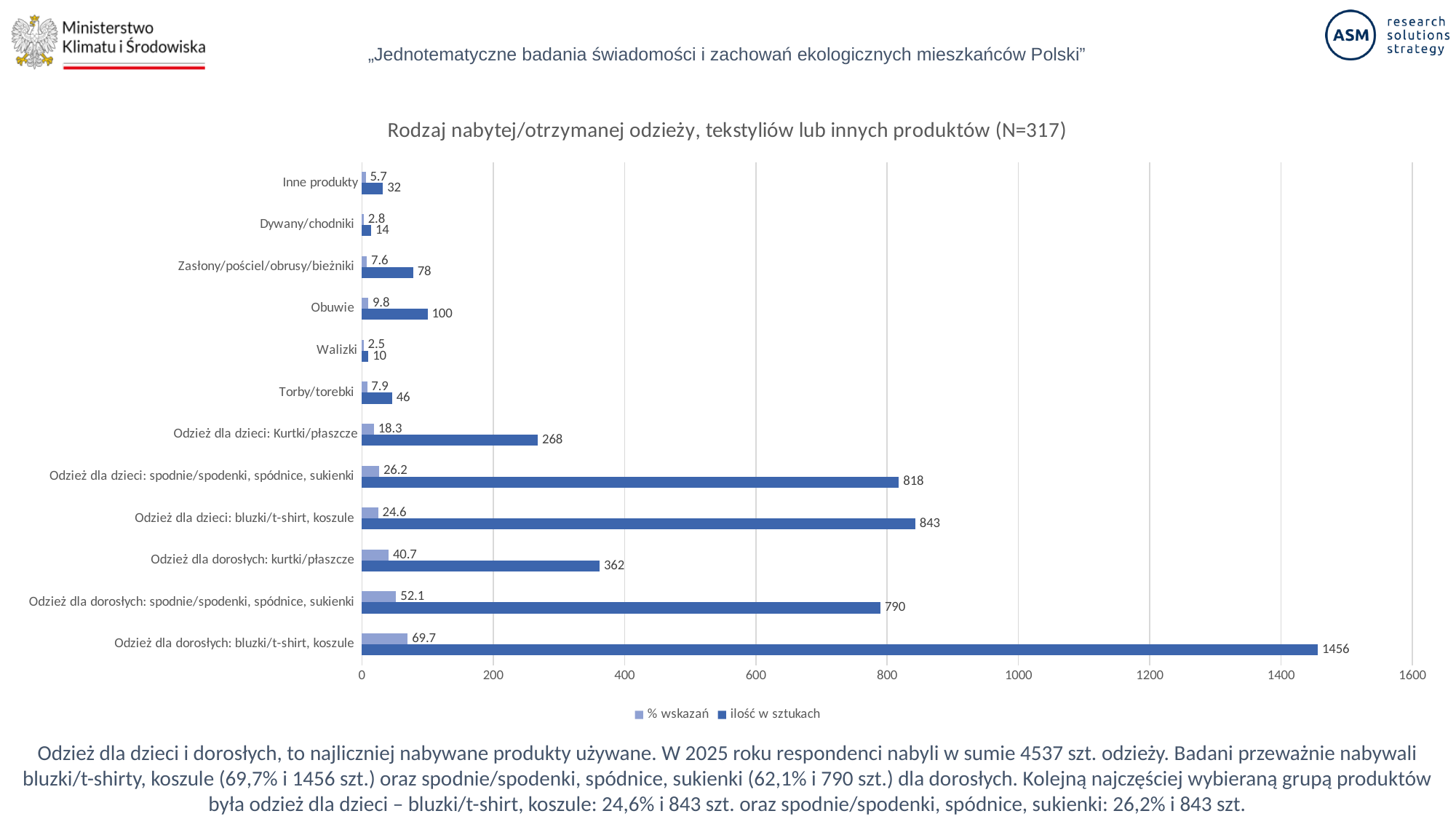
What is the 'ilość w sztukach' value for 'Obuwie'? 100 Which has a larger 'ilość w sztukach' value: 'Odzież dla dorosłych: kurtki/płaszcze' or 'Odzież dla dzieci: Kurtki/płaszcze'? Odzież dla dorosłych: kurtki/płaszcze What kind of chart is shown on the slide? bar chart Is the 'ilość w sztukach' value for 'Odzież dla dorosłych: spodnie/spodenki, spódnice, sukienki' greater or less than 800? less What is the title of the chart? Rodzaj nabytej/otrzymanej odzieży, tekstyliów lub innych produktów (N=317) What is the '% wskazań' value for 'Odzież dla dzieci: Kurtki/płaszcze'? 18.3 Which category has the highest 'ilość w sztukach' value? Odzież dla dorosłych: bluzki/t-shirt, koszule How many categories are shown on the chart? 12 How many series does the legend list? 2 What is the 'ilość w sztukach' value for 'Odzież dla dorosłych: bluzki/t-shirt, koszule'? 1456 Which category has the lowest 'ilość w sztukach' value? Walizki What is the difference in 'ilość w sztukach' between 'Odzież dla dzieci: bluzki/t-shirt, koszule' and 'Odzież dla dzieci: spodnie/spodenki, spódnice, sukienki'? 25